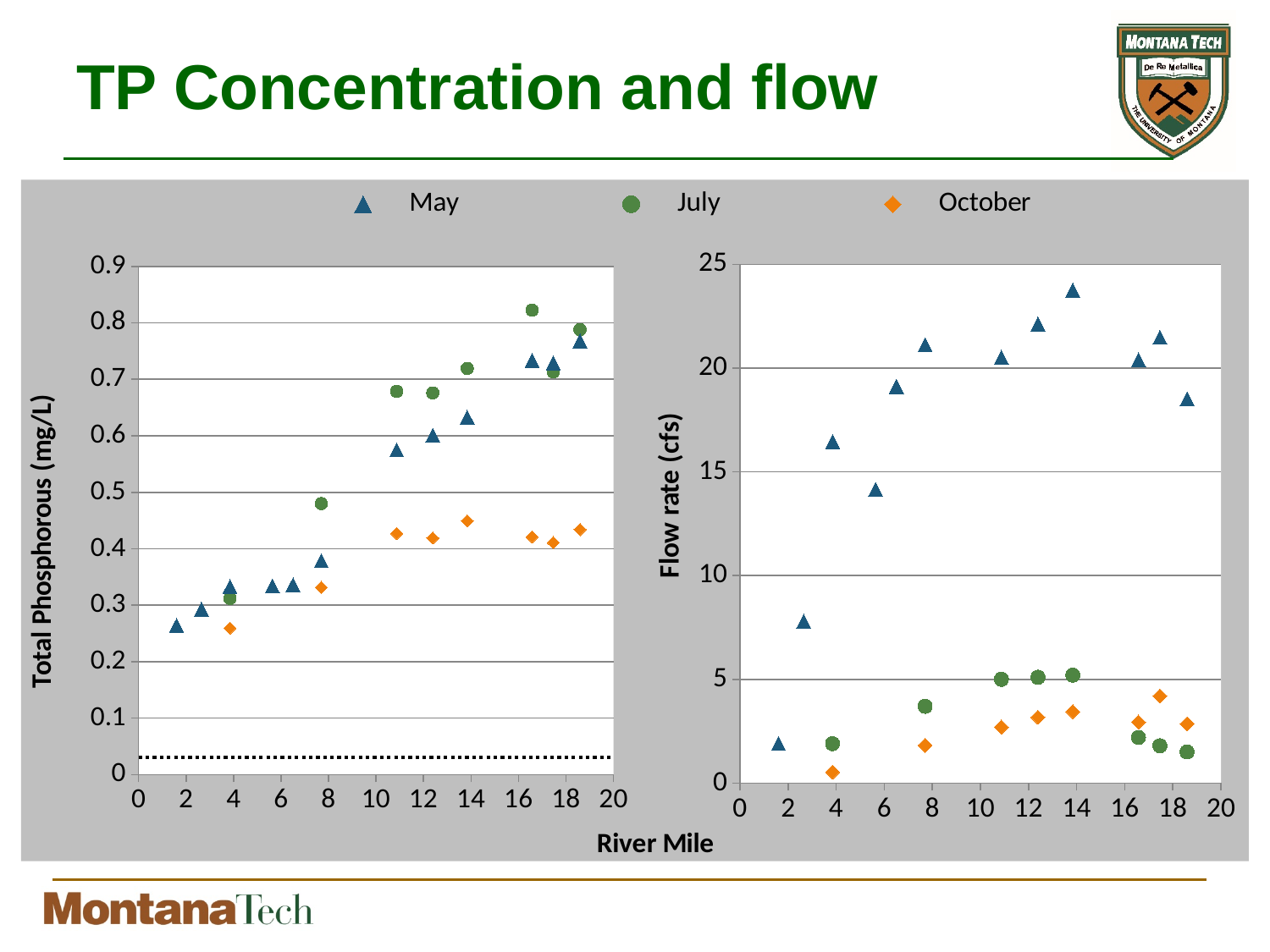
In the right chart (Flow rate), how many October points are plotted? 8 In the right chart (Flow rate), which series has the highest flow rate values? May What kind of chart is the left chart (Total Phosphorous)? Scatter chart In the left chart (Total Phosphorous), do the May values generally rise or fall as river mile increases? Rise In the left chart (Total Phosphorous), is the July value at about river mile 8 greater or less than 0.4? greater In the right chart (Flow rate), is the May value at about river mile 14 greater or less than 20? greater In the left chart (Total Phosphorous), is the May value at about river mile 2 greater or less than 0.3? less How many series does the legend list? 3 In the right chart (Flow rate), at about river mile 12, which series has the larger value, May or July? May What is the y-axis title of the right chart? Flow rate (cfs) What is the shared x-axis title of the two charts? River Mile